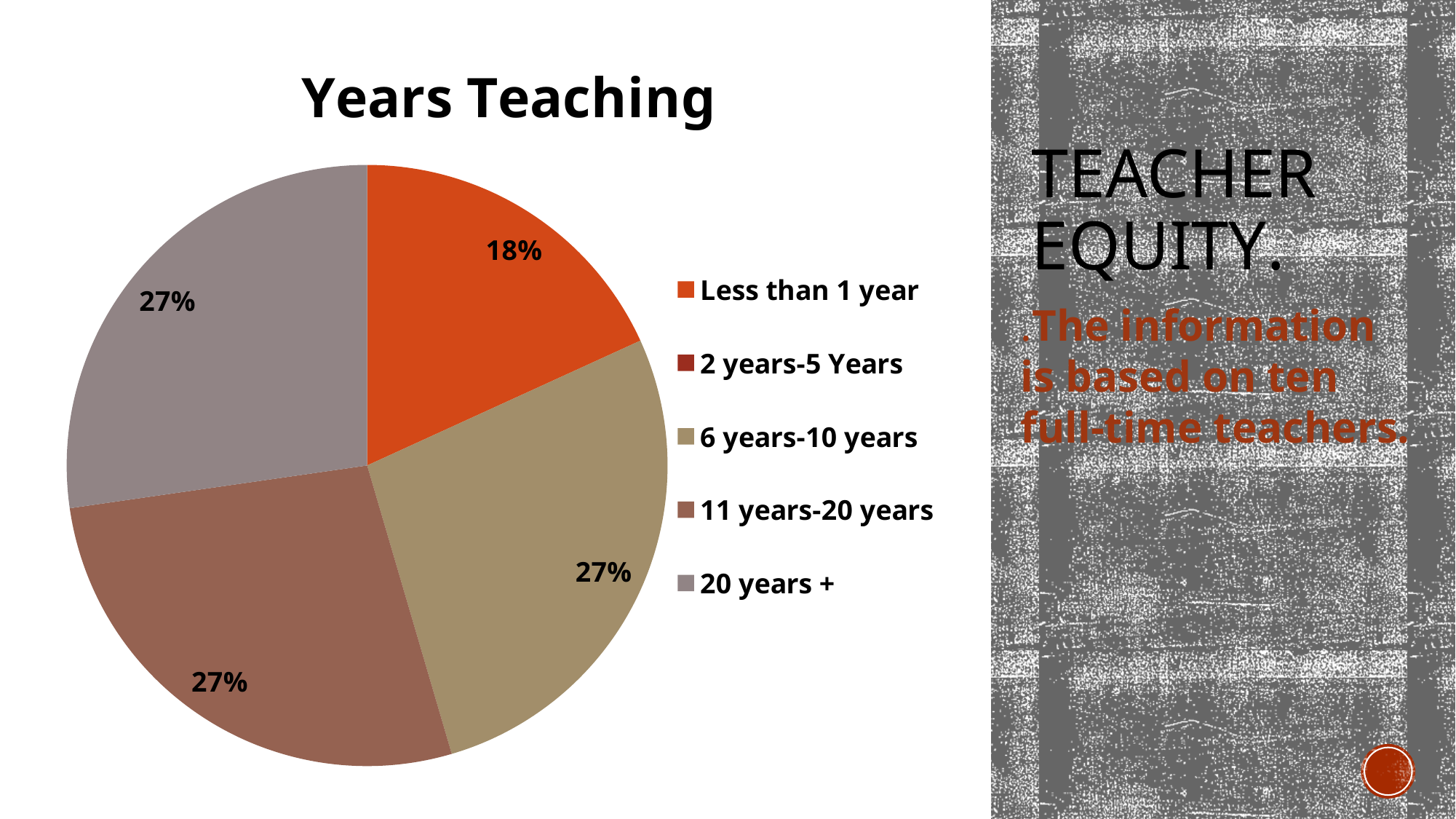
What kind of chart is shown on the slide? Pie chart Which is larger, the slice for Less than 1 year or the slice for 11 years-20 years? 11 years-20 years What share of the pie does the 20 years + slice take? 27% How many slices with data labels are visible in the pie? 4 Which legend category has no visible slice in the pie? 2 years-5 Years What percentage of teachers have been teaching less than 1 year? 18% Which category has the smallest labelled slice in the pie? Less than 1 year What is the title of the chart? Years Teaching What is the difference in percentage points between the 20 years + slice and the Less than 1 year slice? 9 What percentage is shown for 11 years-20 years? 27% What share of the pie is the 6 years-10 years slice? 27% How many entries does the legend list? 5